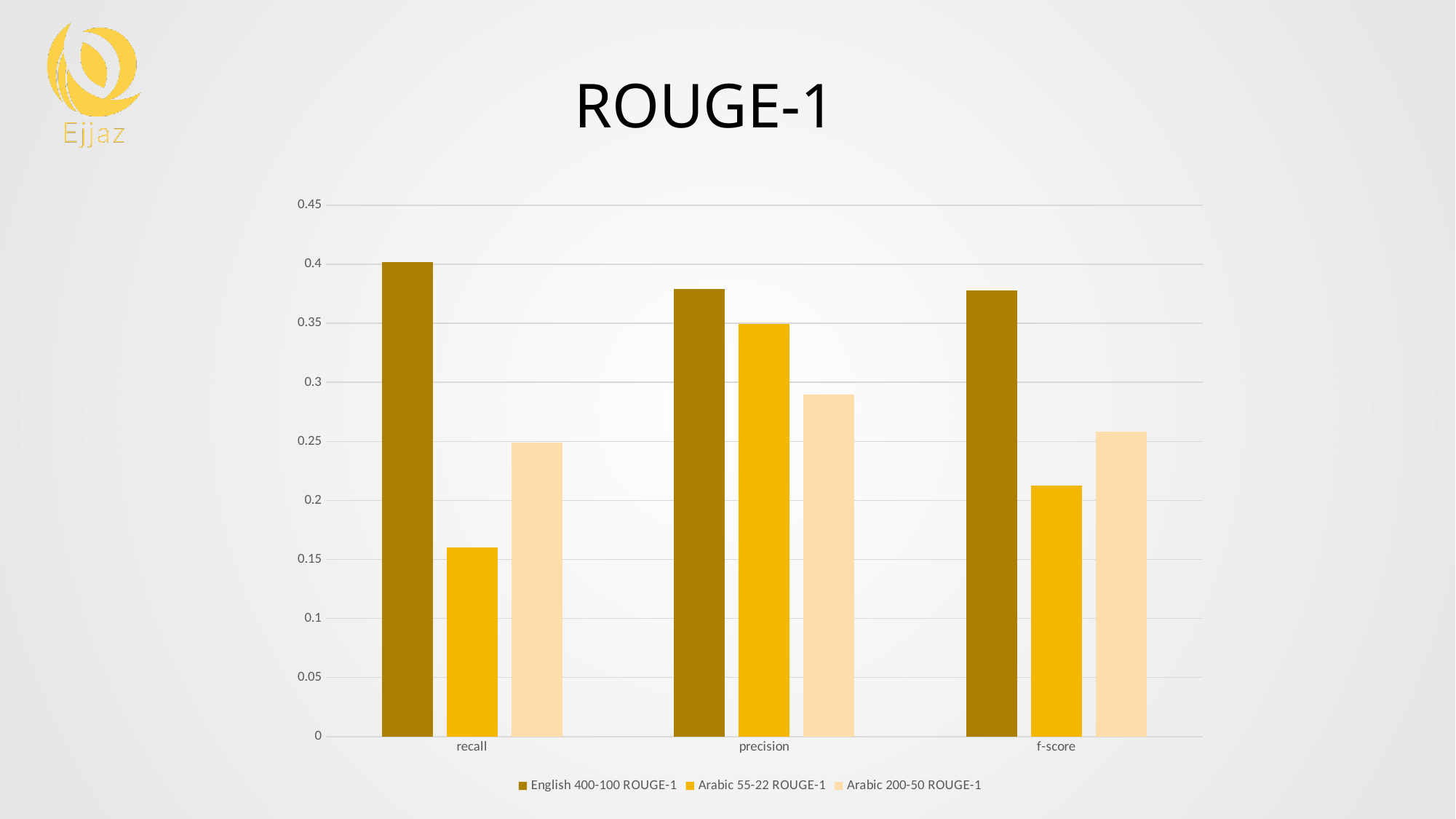
Is the value for Arabic 55-22 ROUGE-1 recall greater or less than 0.2? less Is the value for English 400-100 ROUGE-1 recall greater or less than 0.35? greater Is the value for Arabic 200-50 ROUGE-1 precision greater or less than 0.25? greater How many series does the legend list? 3 How many categories are shown on the x axis? 3 What is the title of the chart? ROUGE-1 Which series has the lowest value for f-score? Arabic 55-22 ROUGE-1 Which series has the lowest value for recall? Arabic 55-22 ROUGE-1 Which series has the highest value for recall? English 400-100 ROUGE-1 Which series has the lowest value for precision? Arabic 200-50 ROUGE-1 What kind of chart is shown on the slide? bar chart For f-score, which is larger: Arabic 55-22 ROUGE-1 or Arabic 200-50 ROUGE-1? Arabic 200-50 ROUGE-1